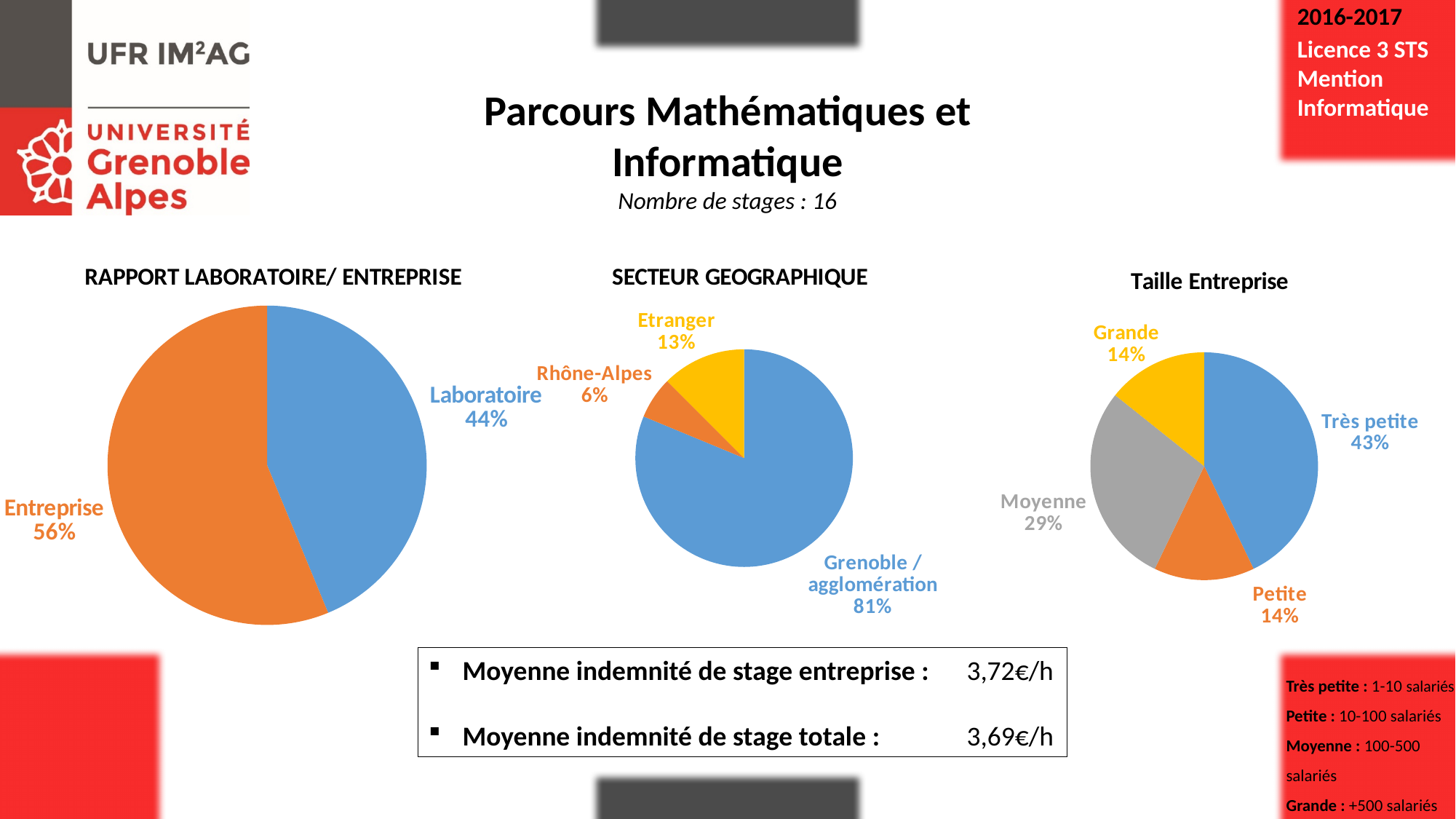
In the Taille Entreprise chart, what is the value for Moyenne? 29% In the RAPPORT LABORATOIRE/ ENTREPRISE chart, what is the value for Laboratoire? 44% How many categories does the Taille Entreprise chart show? 4 In the RAPPORT LABORATOIRE/ ENTREPRISE chart, what share does Entreprise have? 56% In the RAPPORT LABORATOIRE/ ENTREPRISE chart, which slice is larger, Entreprise or Laboratoire? Entreprise In the Taille Entreprise chart, what is the difference between Très petite and Moyenne? 14% In the SECTEUR GEOGRAPHIQUE chart, what is the value for Grenoble / agglomération? 81% In the Taille Entreprise chart, which category has the largest share? Très petite In the SECTEUR GEOGRAPHIQUE chart, what is the difference between Etranger and Rhône-Alpes? 7% How many categories does the SECTEUR GEOGRAPHIQUE chart show? 3 What kind of chart is the Taille Entreprise chart? Pie chart In the SECTEUR GEOGRAPHIQUE chart, which category has the smallest share? Rhône-Alpes